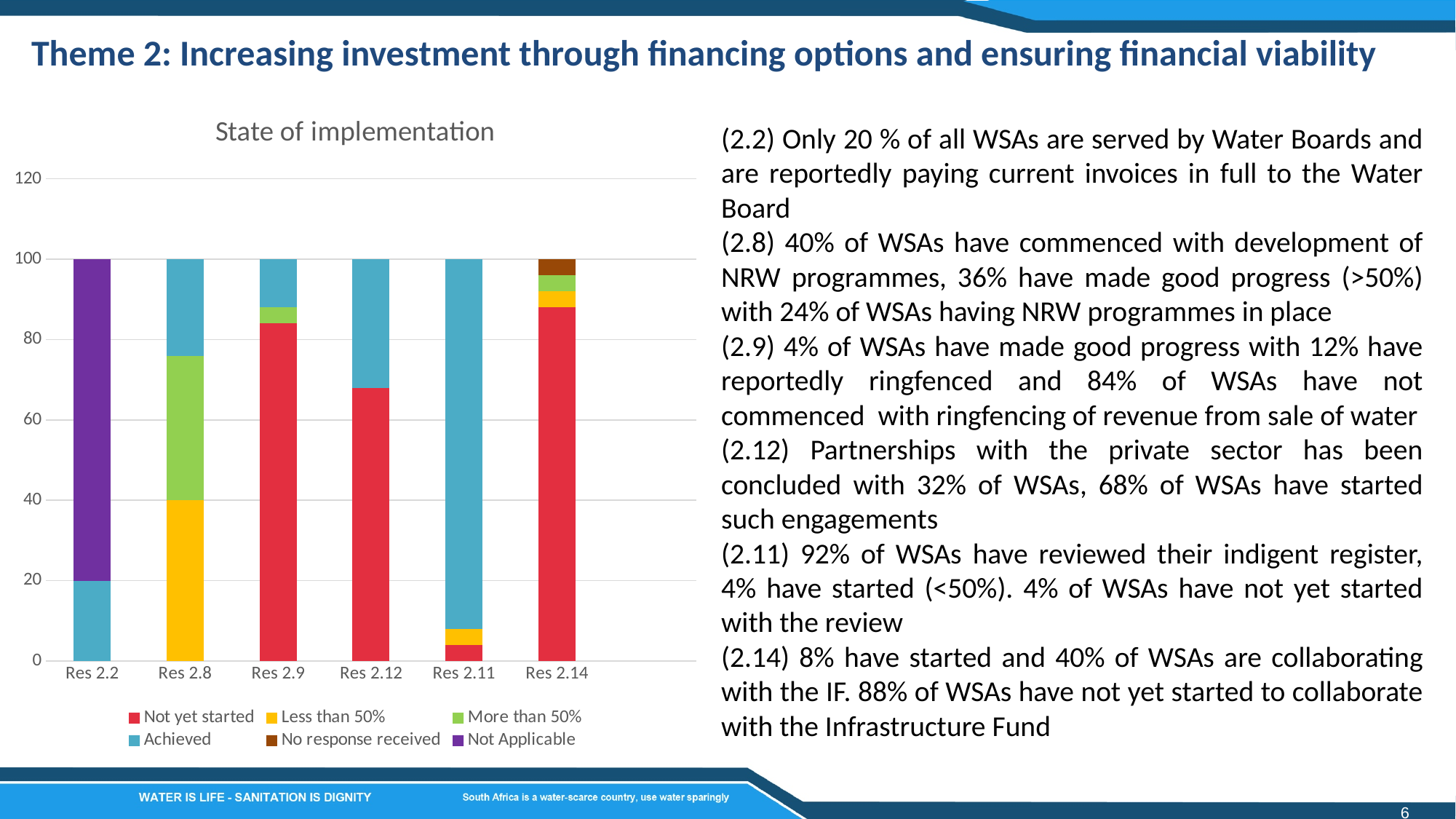
What kind of chart is shown on the slide? Stacked bar chart How many categories are shown on the x axis of the chart? 6 Is the Not yet started value for Res 2.11 greater or less than 20? less How many series does the chart legend list? 6 Which category is the only one with a Not Applicable segment? Res 2.2 What value does the top of the Less than 50% segment for Res 2.8 reach on the axis? 40 Which category has the largest Achieved segment? Res 2.11 What is the title of the chart? State of implementation What is the total height of the stacked bar for Res 2.8? 100 What value does the top of the Achieved segment for Res 2.2 reach on the axis? 20 Which is larger, the Not yet started value for Res 2.9 or for Res 2.12? Res 2.9 Is the Not yet started value for Res 2.12 greater or less than 60? greater